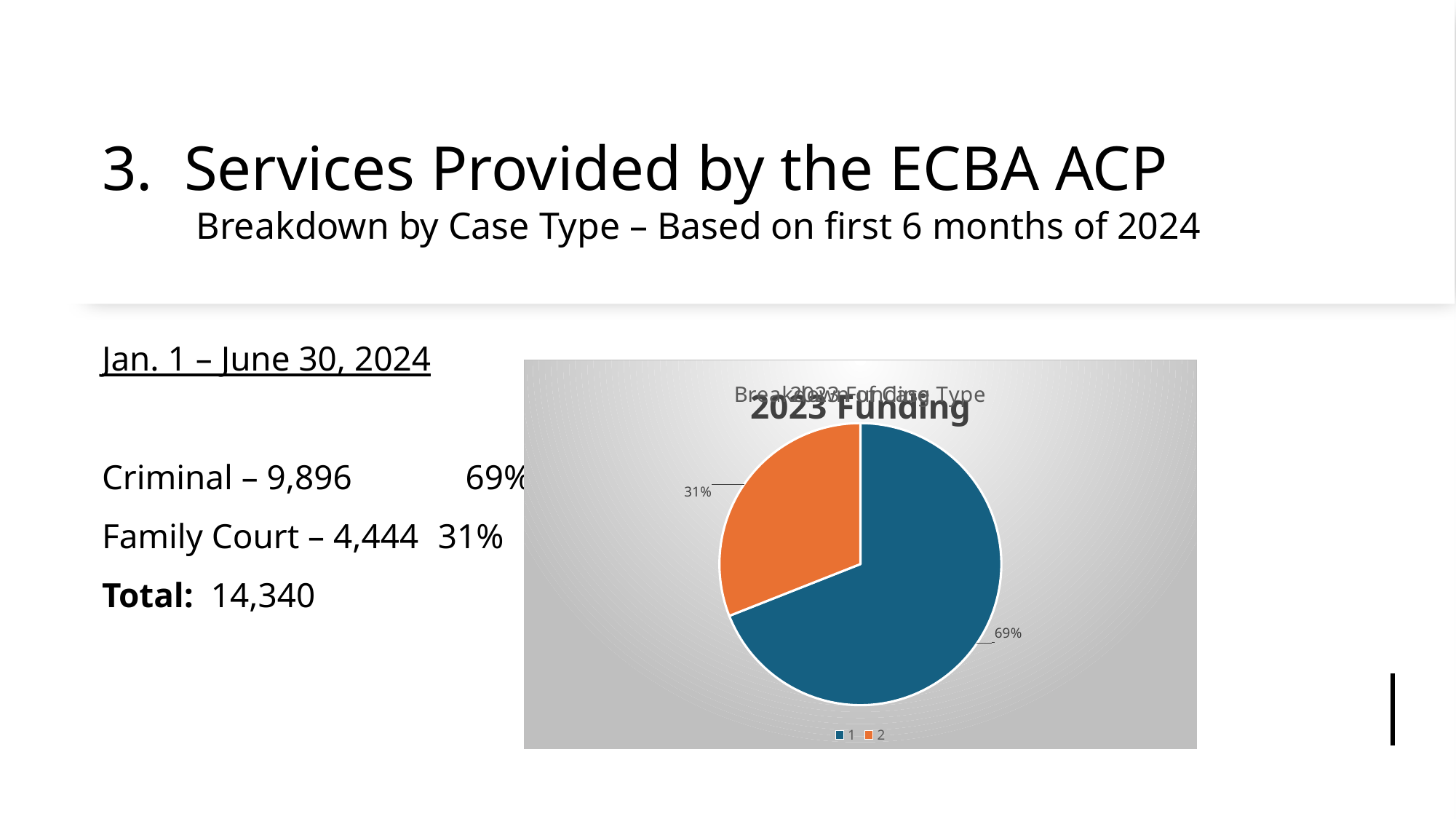
What colour is the slice labelled 69% in the pie chart? blue What kind of chart is shown on the slide? pie chart What percentage is shown on the orange slice of the pie chart? 31% Which slice of the pie chart is the smallest, the blue one or the orange one? orange Is the blue slice of the pie chart larger or smaller than the orange slice? larger How many entries does the pie chart's legend list? 2 What percentage is shown on the blue slice of the pie chart? 69% What are the two legend entries shown below the pie chart? 1 and 2 Which slice of the pie chart is the largest, the blue one or the orange one? blue How many slices does the pie chart have? 2 What is the difference in percentage points between the two slices of the pie chart? 38